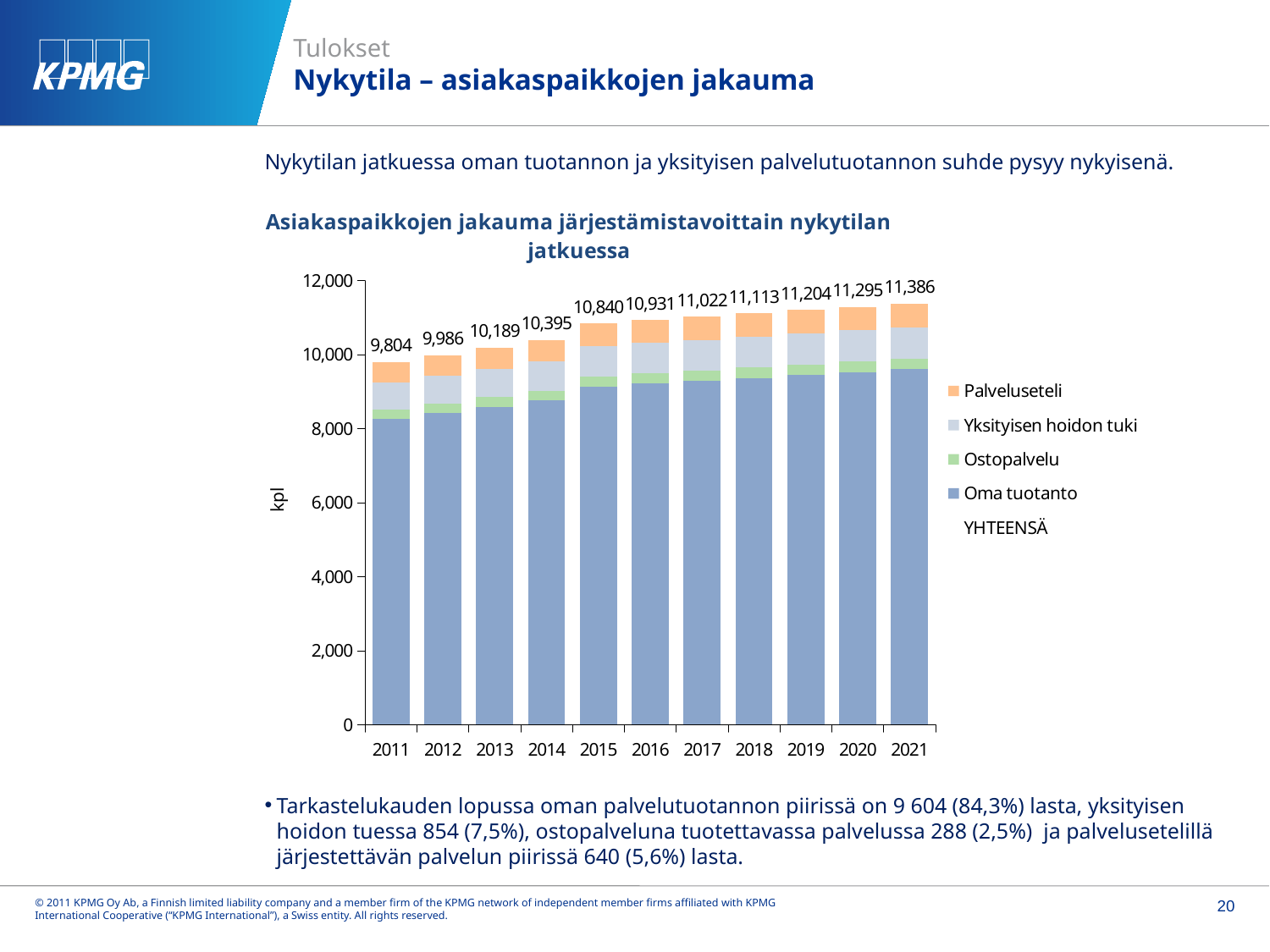
Which year has the lowest total? 2011 What is the total value shown for 2011? 9,804 Is the value of Oma tuotanto for 2011 greater or less than 10,000? less Do the totals rise or fall from 2011 to 2021? Rise Which is larger, the total for 2014 or the total for 2015? 2015 What kind of chart is shown on the slide? Stacked bar chart What is the total value shown for 2021? 11,386 What is the difference between the totals for 2021 and 2011? 1,582 Which year has the highest total? 2021 What is the total value shown for 2015? 10,840 How many entries does the legend list? 5 How many years are shown on the x axis? 11